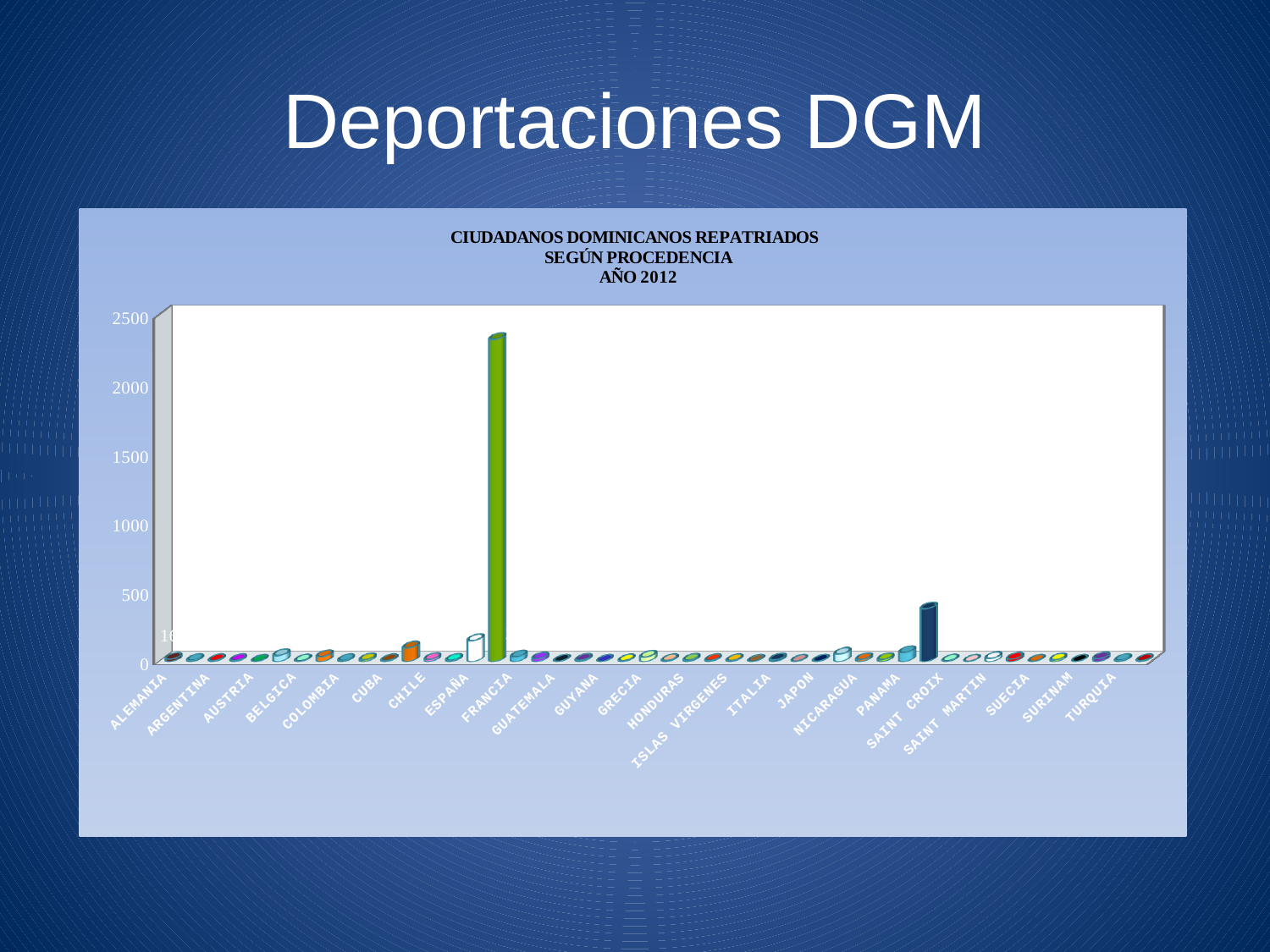
Is the value of the tallest bar greater or less than 2500? less What is the last category label on the x axis? TURQUIA Which is taller, the tall green bar or the dark blue bar? the green bar What is the first category label on the x axis? ALEMANIA Is the value of the tallest bar greater or less than 2000? greater How many category labels are printed along the x axis? 23 Is the value for ALEMANIA greater or less than 500? less Which year does the chart title refer to? 2012 What is the title of the chart? CIUDADANOS DOMINICANOS REPATRIADOS SEGÚN PROCEDENCIA AÑO 2012 What kind of chart is shown on the slide? bar chart What is the highest value shown on the y axis? 2500